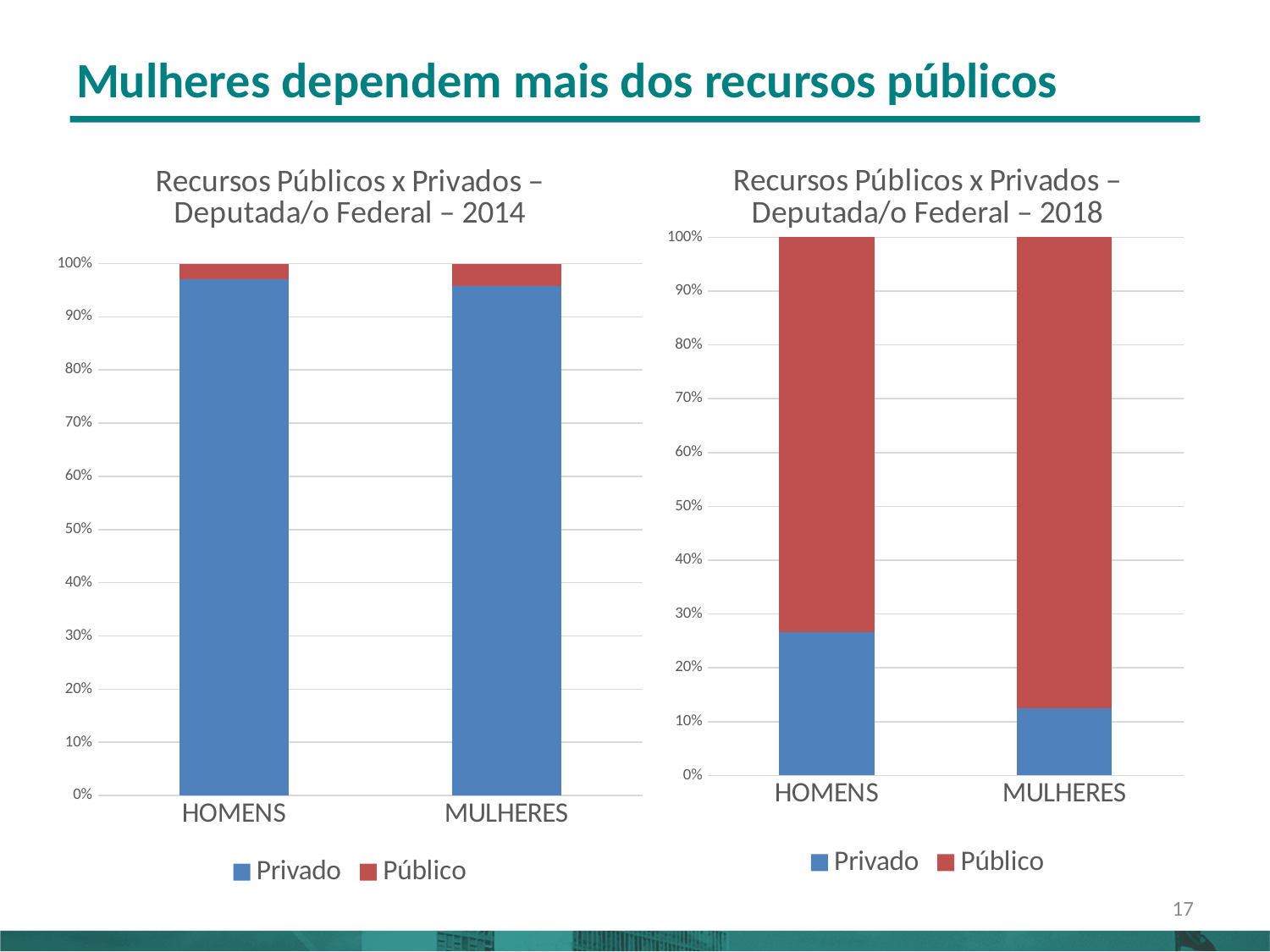
In the 'Recursos Públicos x Privados – Deputada/o Federal – 2018' chart, is the Privado value for MULHERES greater or less than 20%? less In the 'Recursos Públicos x Privados – Deputada/o Federal – 2018' chart, which category has the larger Privado share, HOMENS or MULHERES? HOMENS What is the title of the chart on the left side of the slide? Recursos Públicos x Privados – Deputada/o Federal – 2014 What kind of chart is the 'Recursos Públicos x Privados – Deputada/o Federal – 2018' chart? stacked bar chart In the 'Recursos Públicos x Privados – Deputada/o Federal – 2014' chart, which series makes up the larger part of the HOMENS bar, Privado or Público? Privado In the 'Recursos Públicos x Privados – Deputada/o Federal – 2018' chart, is the Privado value for HOMENS greater or less than 30%? less In the 'Recursos Públicos x Privados – Deputada/o Federal – 2018' chart, what is the total height of the MULHERES stacked bar? 100% Which colour represents the Público series in the 'Recursos Públicos x Privados – Deputada/o Federal – 2018' chart? red In the 'Recursos Públicos x Privados – Deputada/o Federal – 2018' chart, which category has the larger Público share, HOMENS or MULHERES? MULHERES How many categories are shown on the x axis of the 'Recursos Públicos x Privados – Deputada/o Federal – 2018' chart? 2 In the 'Recursos Públicos x Privados – Deputada/o Federal – 2014' chart, is the Privado value for HOMENS greater or less than 90%? greater How many series does the legend list in the 'Recursos Públicos x Privados – Deputada/o Federal – 2014' chart? 2